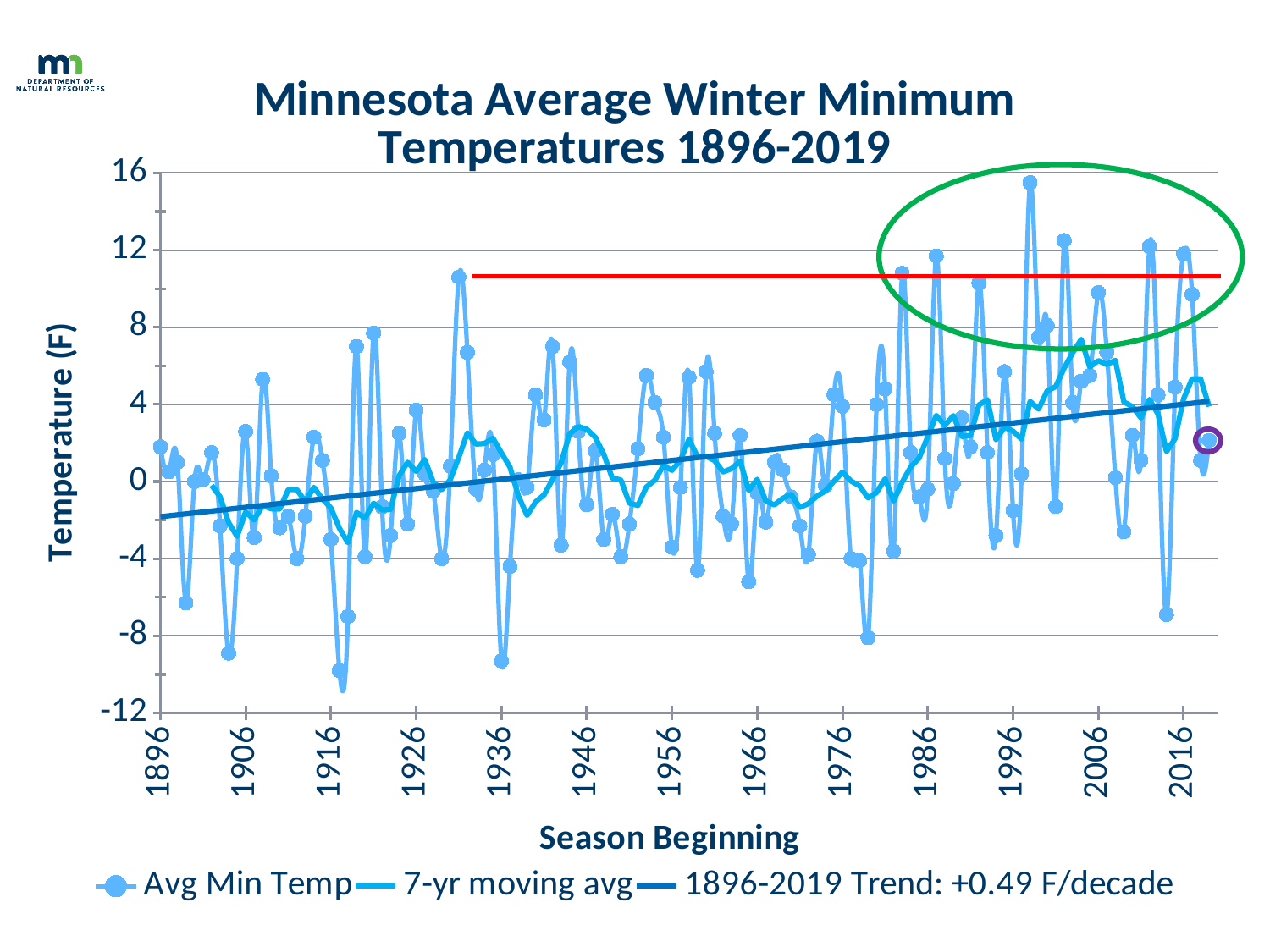
Is the highest Avg Min Temp value on the chart greater or less than 12? greater According to the legend, what is the 1896-2019 trend in F per decade? +0.49 F/decade Does the 1896-2019 trend line rise or fall from left to right along the x axis? Rises Is the highest Avg Min Temp value greater or less than 8? greater How many series does the legend list? 3 What is the title of the chart? Minnesota Average Winter Minimum Temperatures 1896-2019 Is the lowest Avg Min Temp value on the chart greater or less than -8? less What kind of chart is shown on the slide? Line chart